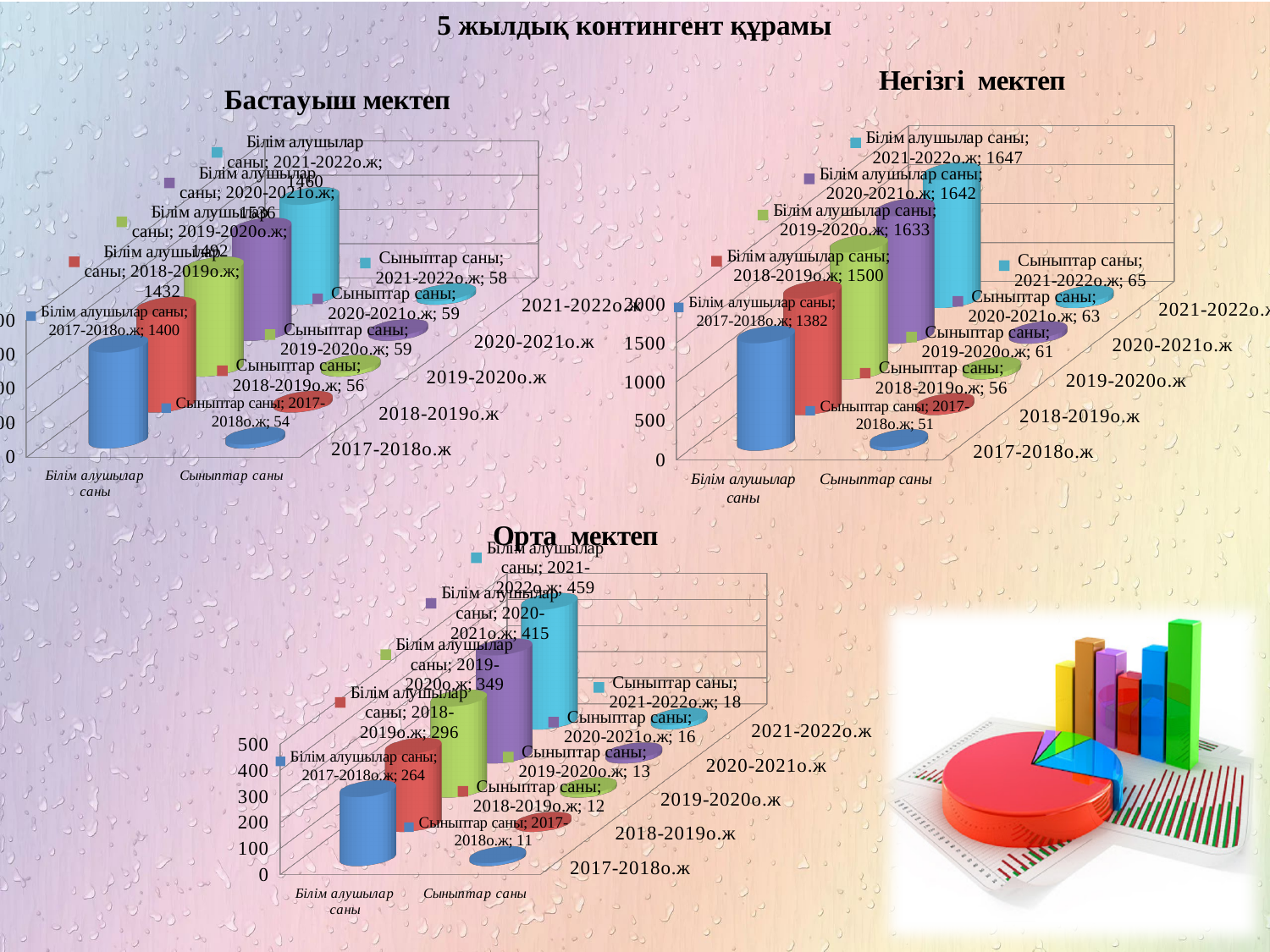
In the Орта мектеп chart, which year has the highest value of Сыныптар саны? 2021-2022о.ж In the Орта мектеп chart, does Білім алушылар саны rise or fall from 2017-2018о.ж to 2021-2022о.ж? rise In the Бастауыш мектеп chart, which is larger: Білім алушылар саны for 2018-2019о.ж or for 2017-2018о.ж? 2018-2019о.ж In the Негізгі мектеп chart, what is the difference between Сыныптар саны for 2021-2022о.ж and 2020-2021о.ж? 2 What kind of chart is the Орта мектеп chart? bar chart In the Негізгі мектеп chart, what is the value of Сыныптар саны for 2017-2018о.ж? 51 In the Орта мектеп chart, what is the difference between Білім алушылар саны for 2021-2022о.ж and 2017-2018о.ж? 195 In the Бастауыш мектеп chart, what is the value of Сыныптар саны for 2017-2018о.ж? 54 In the Орта мектеп chart, what is the value of Білім алушылар саны for 2019-2020о.ж? 349 In the Негізгі мектеп chart, which year has the lowest value of Білім алушылар саны? 2017-2018о.ж How many years are shown in the Негізгі мектеп chart? 5 In the Негізгі мектеп chart, what is the value of Білім алушылар саны for 2021-2022о.ж? 1647